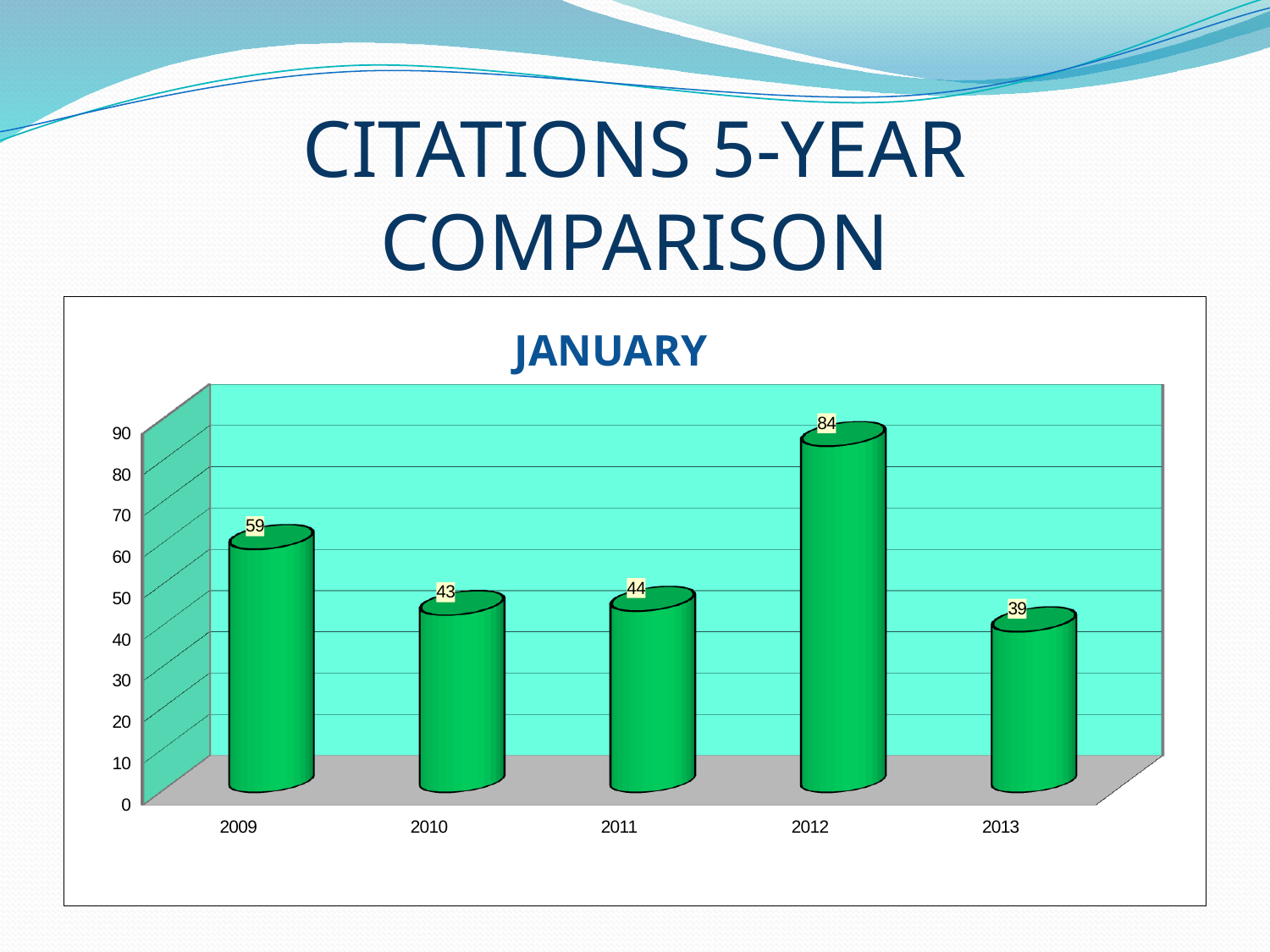
What is the difference between the values for 2012 and 2009? 25 Which year has the highest value? 2012 How many years are shown on the chart? 5 Which is larger, the value for 2009 or the value for 2013? 2009 What is the difference between the values for 2011 and 2010? 1 What is the value for 2012? 84 What is the value for 2013? 39 What kind of chart is shown on the slide? bar chart What is the value for 2009? 59 Is the value for 2012 greater or less than 80? greater What is the title of the chart? JANUARY Which year has the lowest value? 2013